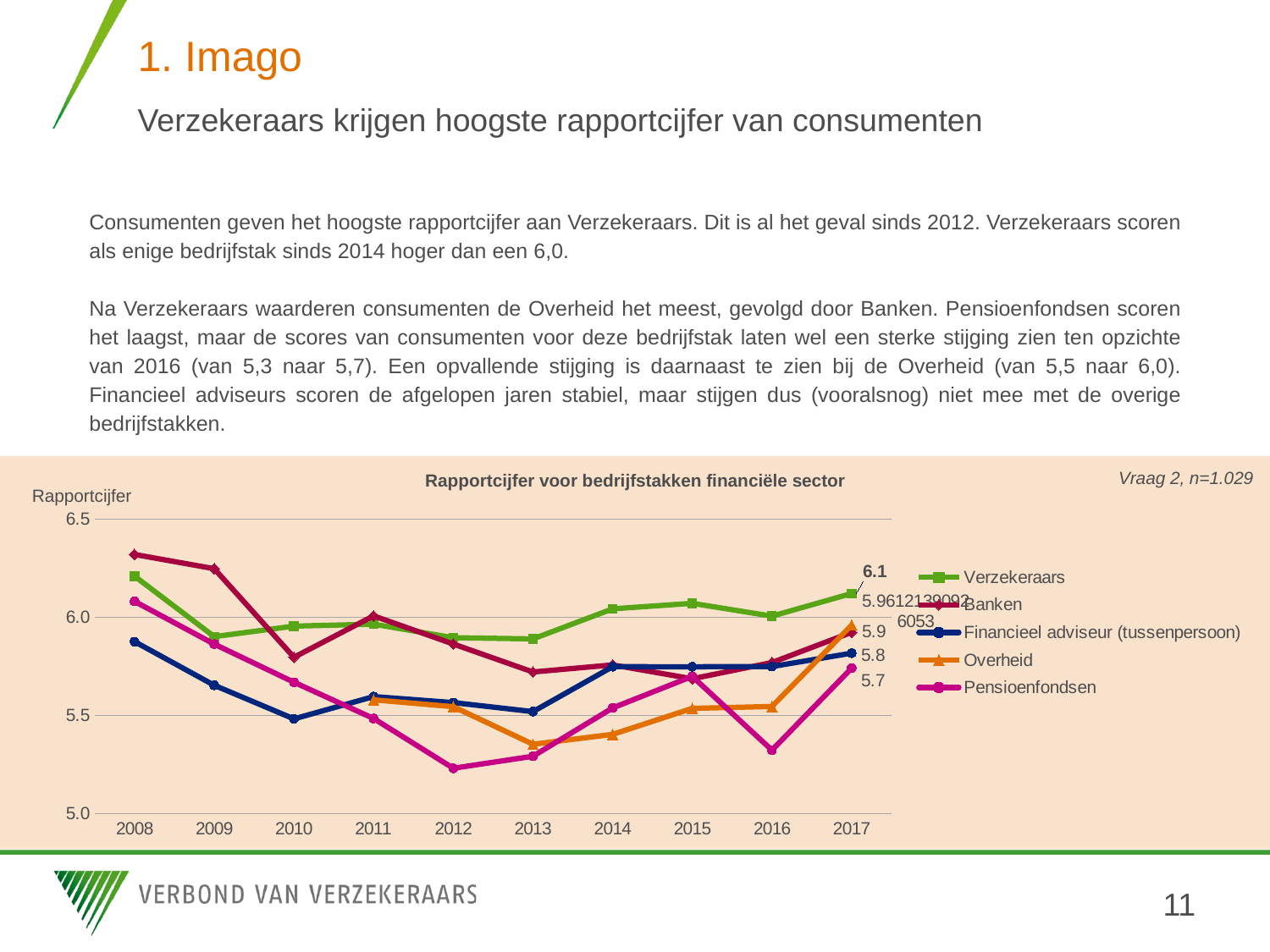
What is the value for Overheid in 2017? 5.96121390926053 How many years are shown on the x axis of the chart? 10 What is the value for Financieel adviseur (tussenpersoon) in 2017? 5.8 Which series has the highest value in 2017? Verzekeraars Is the value for Banken in 2008 greater or less than 6.0? greater What is the difference between the 2017 values for Verzekeraars and Pensioenfondsen? 0.4 What is the value for Pensioenfondsen in 2017? 5.7 How many series does the legend of the chart list? 5 Is the value for Pensioenfondsen in 2012 greater or less than 5.5? less What is the title of the chart? Rapportcijfer voor bedrijfstakken financiële sector What kind of chart is shown on the slide? line chart What is the value for Verzekeraars in 2017? 6.1